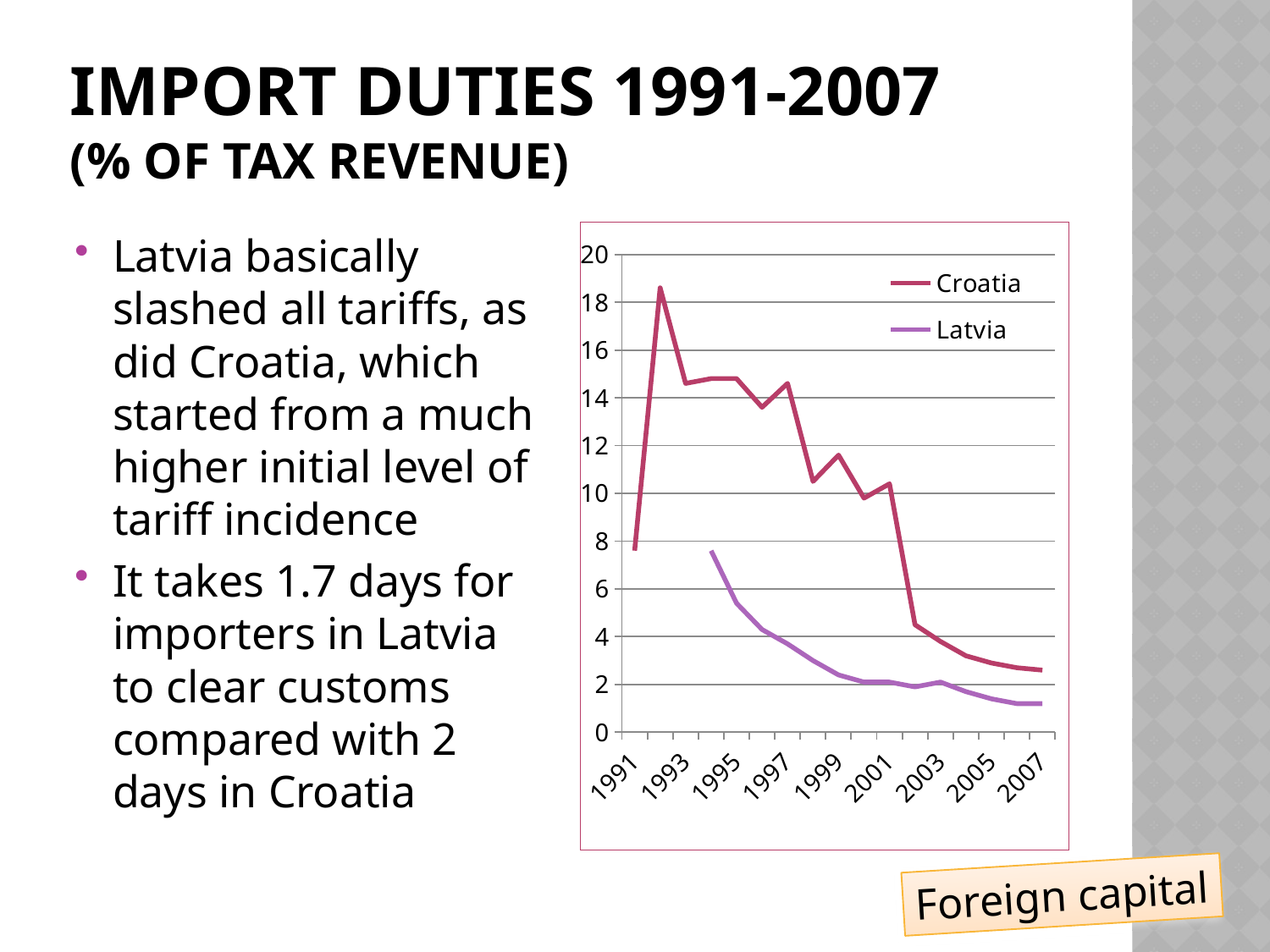
Does the Latvia line generally rise or fall across the years shown? fall How many year labels are shown on the x axis of the chart? 9 What kind of chart is shown on the slide? line chart How many series does the chart's legend list? 2 In 1995, which country has the higher value, Croatia or Latvia? Croatia Which two countries are shown in the chart's legend? Croatia and Latvia Is the value for Latvia in 2007 greater or less than 2? less Is the value for Latvia in 1999 greater or less than 4? less Is the value for Croatia in 1997 greater or less than 12? greater Which series is drawn in purple in the chart? Latvia Does the Croatia line generally rise or fall from 1993 to 2007? fall